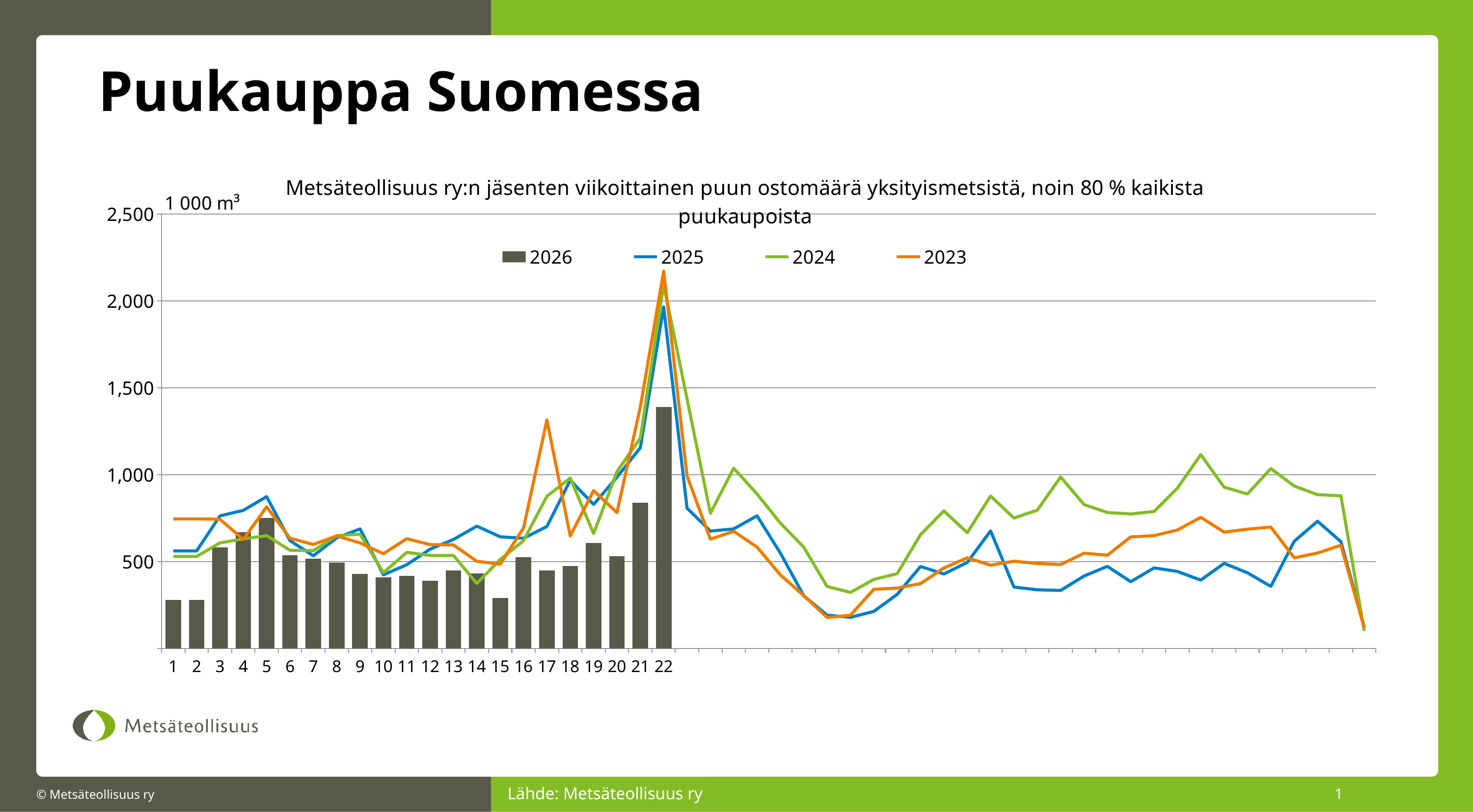
At week 17, which series has the higher value: 2023 or 2025? 2023 How many series does the chart legend list? 4 Which is larger for 2026: the value for week 22 or the value for week 15? Week 22 What unit is shown on the vertical axis of the chart? 1 000 m³ Do the 2026 bars rise or fall from week 15 to week 22? Rise How many weeks have a bar plotted for the 2026 series? 22 Is the 2026 value for week 22 greater or less than 1,000? greater Is the 2026 value for week 1 greater or less than 500? less What kind of chart is shown on the slide? A combined bar and line chart In which week is the 2026 bar the highest? Week 22 Is the 2026 value for week 21 greater or less than 500? greater